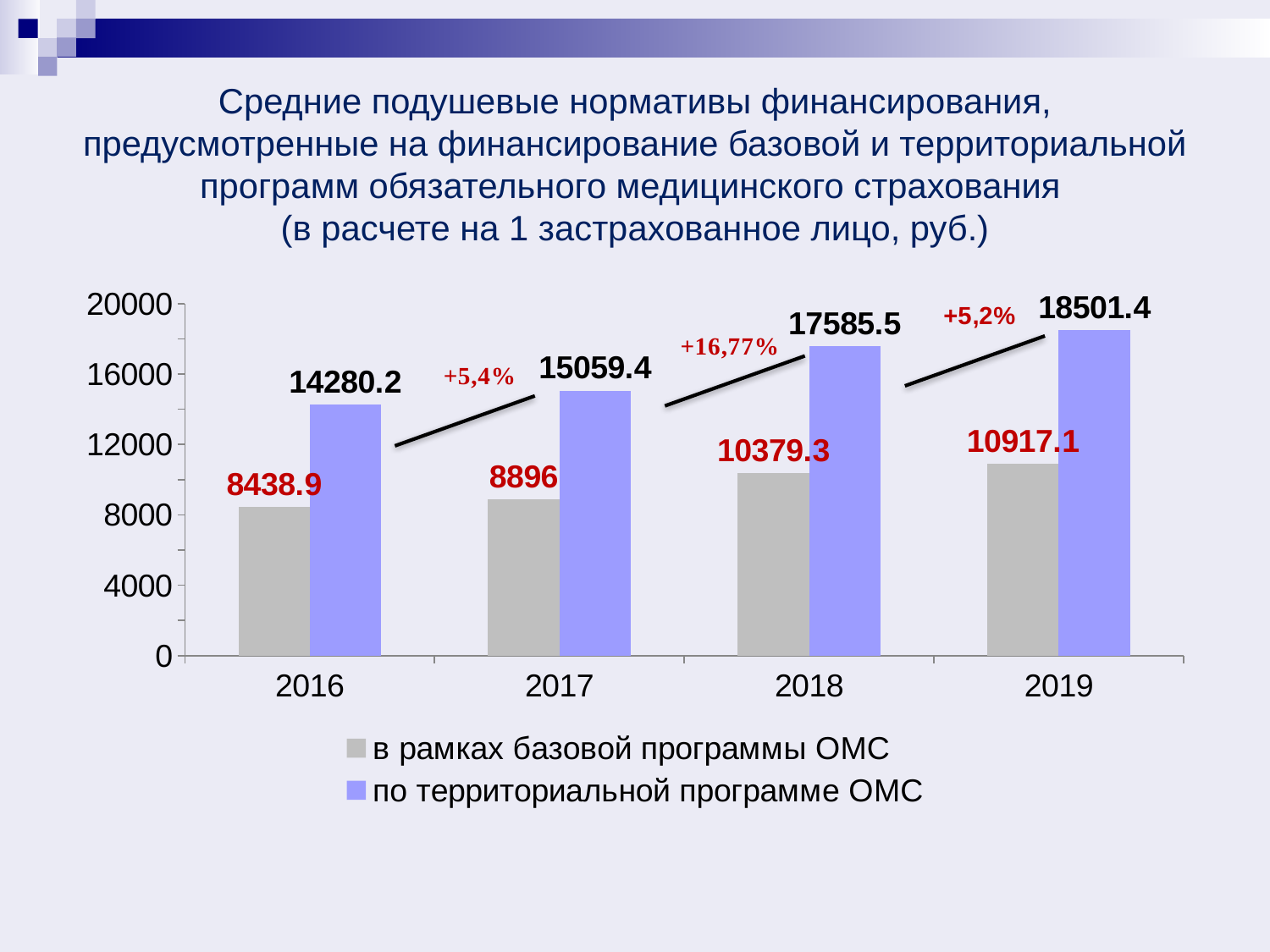
How many years are shown on the x axis? 4 What kind of chart is shown on the slide? bar chart Which is larger: the 2018 value for "в рамках базовой программы ОМС" or the 2016 value for "по территориальной программе ОМС"? 2016 value for "по территориальной программе ОМС" How many series does the legend list? 2 What is the difference between the 2018 and 2017 values in the series "по территориальной программе ОМС"? 2526.1 What is the value for 2019 in the series "по территориальной программе ОМС"? 18501.4 Which year has the lowest value in the series "в рамках базовой программы ОМС"? 2016 What is the value for 2016 in the series "в рамках базовой программы ОМС"? 8438.9 What is the value for 2017 in the series "в рамках базовой программы ОМС"? 8896 Which year has the highest value in the series "по территориальной программе ОМС"? 2019 Do the values in the series "в рамках базовой программы ОМС" rise or fall from 2016 to 2019? rise What percentage growth is annotated between 2017 and 2018? +16,77%